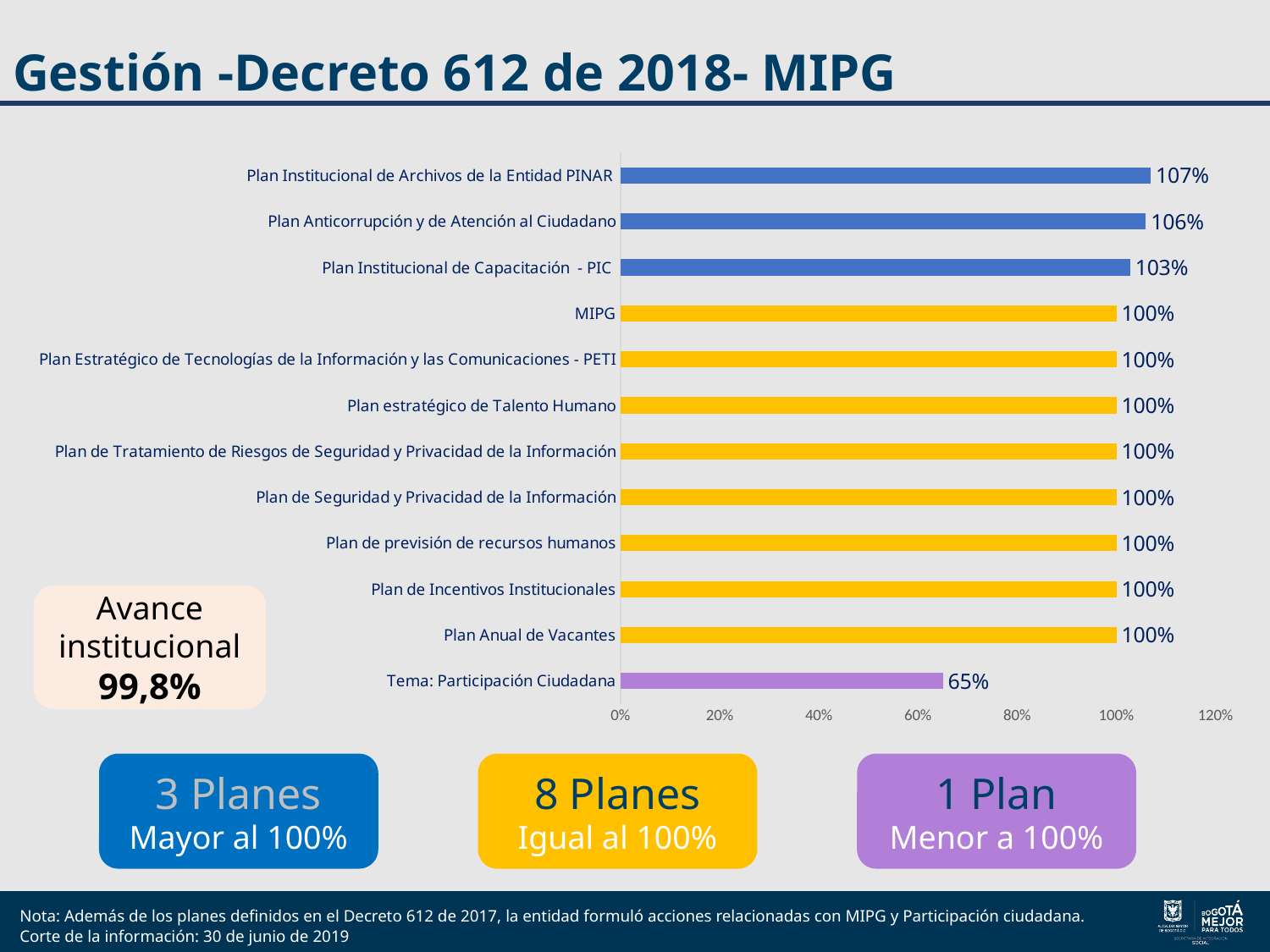
What is the value for Plan Institucional de Capacitación - PIC? 103% What kind of chart is shown on the slide? Bar chart What is the value for Tema: Participación Ciudadana? 65% Is the value for Tema: Participación Ciudadana greater or less than 80%? less What colour is the bar for Tema: Participación Ciudadana? Purple What is the difference between the values for Plan Institucional de Archivos de la Entidad PINAR and Tema: Participación Ciudadana? 42 percentage points Which is larger, the value for Plan Institucional de Capacitación - PIC or the value for MIPG? Plan Institucional de Capacitación - PIC Which category has the highest value? Plan Institucional de Archivos de la Entidad PINAR What is the value for Plan Institucional de Archivos de la Entidad PINAR? 107% Which category has the lowest value? Tema: Participación Ciudadana What is the value for Plan Anticorrupción y de Atención al Ciudadano? 106% How many categories are plotted in the chart? 12